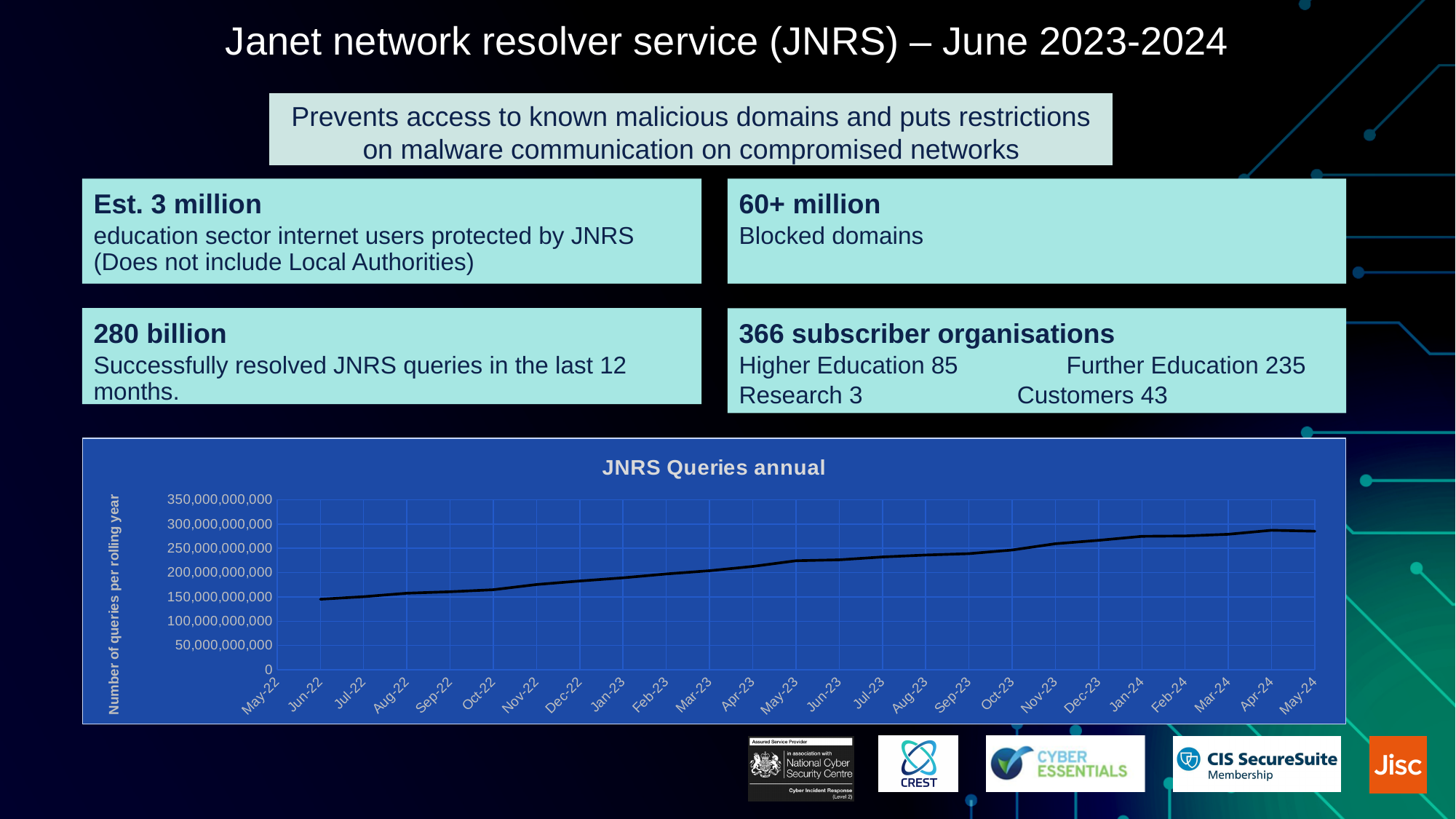
In the 'JNRS Queries annual' chart, which is larger, the value for Dec-22 or the value for Dec-23? Dec-23 In the 'JNRS Queries annual' chart, is the value for Oct-23 greater or less than 200,000,000,000? greater In the 'JNRS Queries annual' chart, is the value for Jan-23 greater or less than 200,000,000,000? less How many lines are plotted in the 'JNRS Queries annual' chart? 1 How many month labels are shown on the x axis of the 'JNRS Queries annual' chart? 25 In the 'JNRS Queries annual' chart, is the value for May-24 greater or less than 250,000,000,000? greater What kind of chart is the 'JNRS Queries annual' chart? Line chart What is the label on the vertical axis of the 'JNRS Queries annual' chart? Number of queries per rolling year In the 'JNRS Queries annual' chart, do the values rise or fall from Jun-22 to May-24? Rise In the 'JNRS Queries annual' chart, which month has the lowest value? Jun-22 What is the title of the chart on the slide? JNRS Queries annual